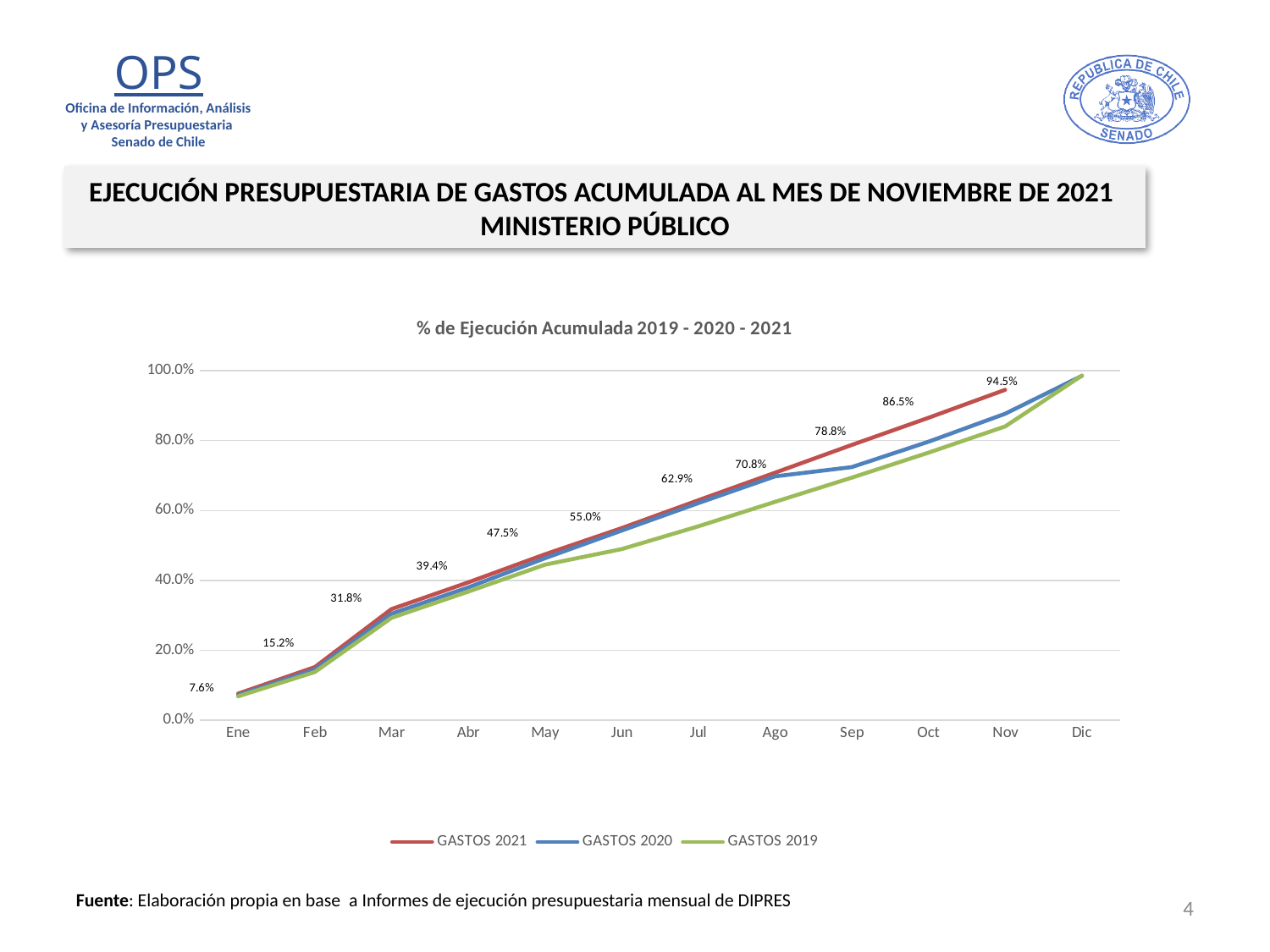
What is the value for GASTOS 2021 in Sep? 78.8% Is the value for GASTOS 2019 in Jun greater or less than 60%? less What is the value for GASTOS 2021 in Ene? 7.6% In Oct, which series is higher, GASTOS 2021 or GASTOS 2019? GASTOS 2021 What is the value for GASTOS 2021 in Jun? 55.0% Do the GASTOS 2021 values rise or fall from Ene to Nov? Rise How many series does the legend list? 3 What is the difference between the GASTOS 2021 values for Nov and Oct? 8.0% How many months are shown on the x axis? 12 In which month does GASTOS 2021 reach its highest labelled value? Nov What type of chart is shown on the slide? Line chart What is the value for GASTOS 2021 in Nov? 94.5%